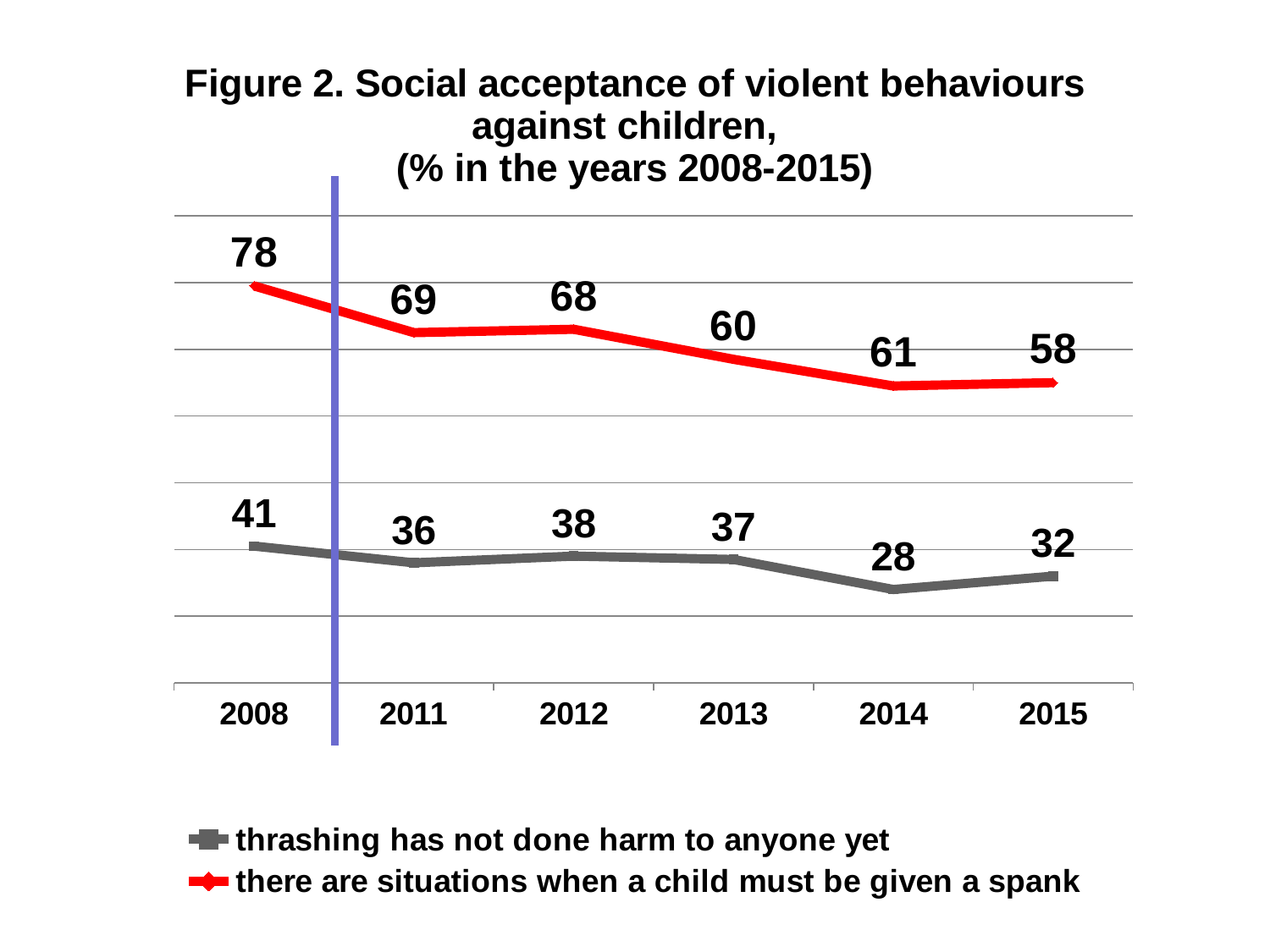
Does the 'there are situations when a child must be given a spank' series generally rise or fall from 2008 to 2015? fall What kind of chart is shown? line chart By how much did 'thrashing has not done harm to anyone yet' change from 2014 to 2015? 4 What is the value for 'there are situations when a child must be given a spank' in 2008? 78 How many years are shown on the x axis? 6 In which year is the 'there are situations when a child must be given a spank' series lowest? 2015 What is the difference between the two series in 2008? 37 How many series does the legend list? 2 What is the value for 'thrashing has not done harm to anyone yet' in 2014? 28 In which year is the 'thrashing has not done harm to anyone yet' series highest? 2008 Which is larger for 'there are situations when a child must be given a spank': the value in 2013 or in 2014? 2014 What is the value for 'there are situations when a child must be given a spank' in 2015? 58